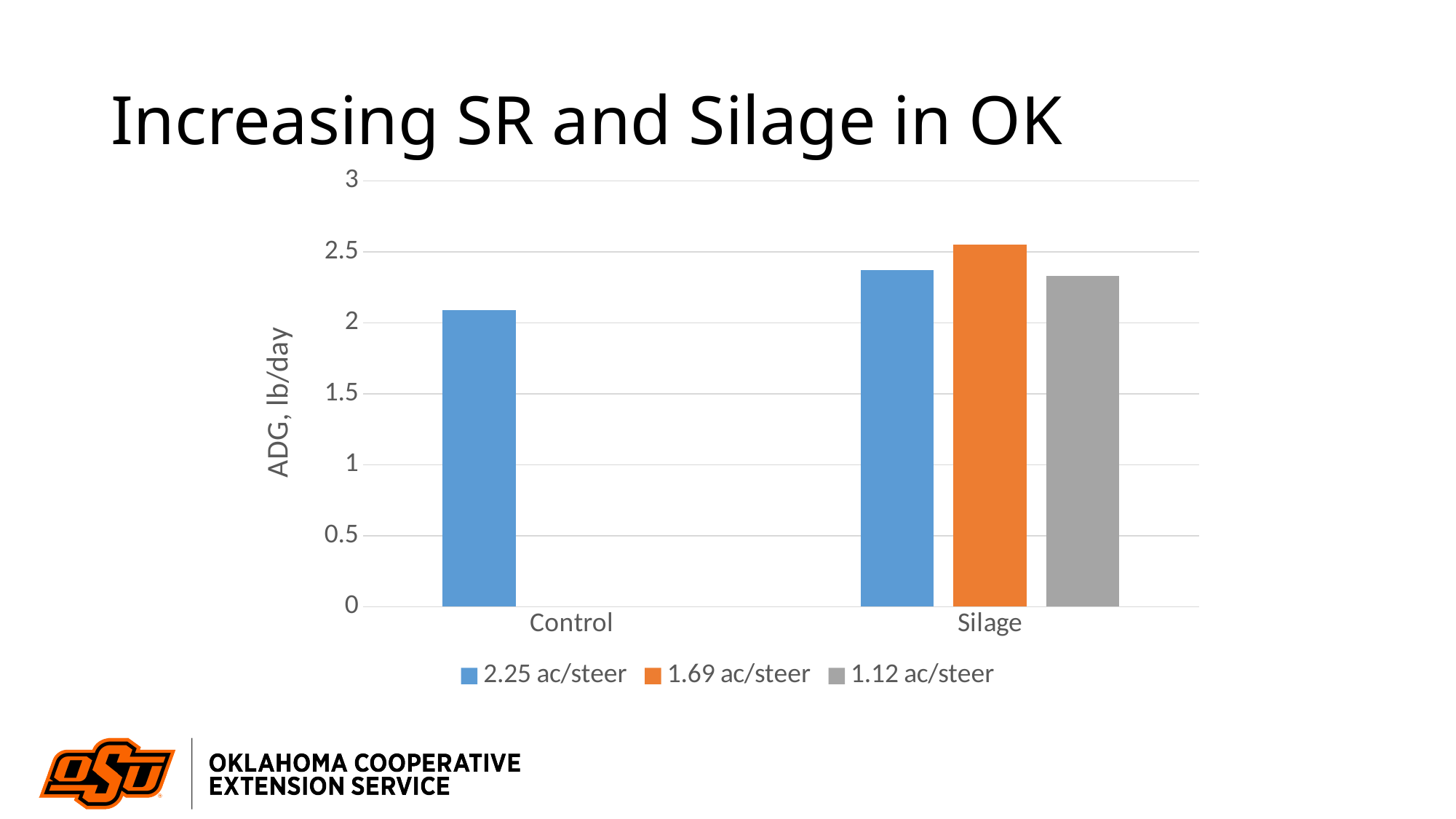
What is the title of the chart? Increasing SR and Silage in OK What kind of chart is shown on the slide? bar chart What is the label on the vertical axis? ADG, lb/day Which category has bars for only one series? Control Is the 1.12 ac/steer value for Silage greater or less than 2.5? less Is the 1.69 ac/steer value for Silage greater or less than 2? greater Is the 2.25 ac/steer value for Control greater or less than 2? greater How many categories are shown on the x axis? 2 How many series does the legend list? 3 Which is larger, the 2.25 ac/steer value for Control or the 2.25 ac/steer value for Silage? Silage Within the Silage category, which series has the highest bar? 1.69 ac/steer